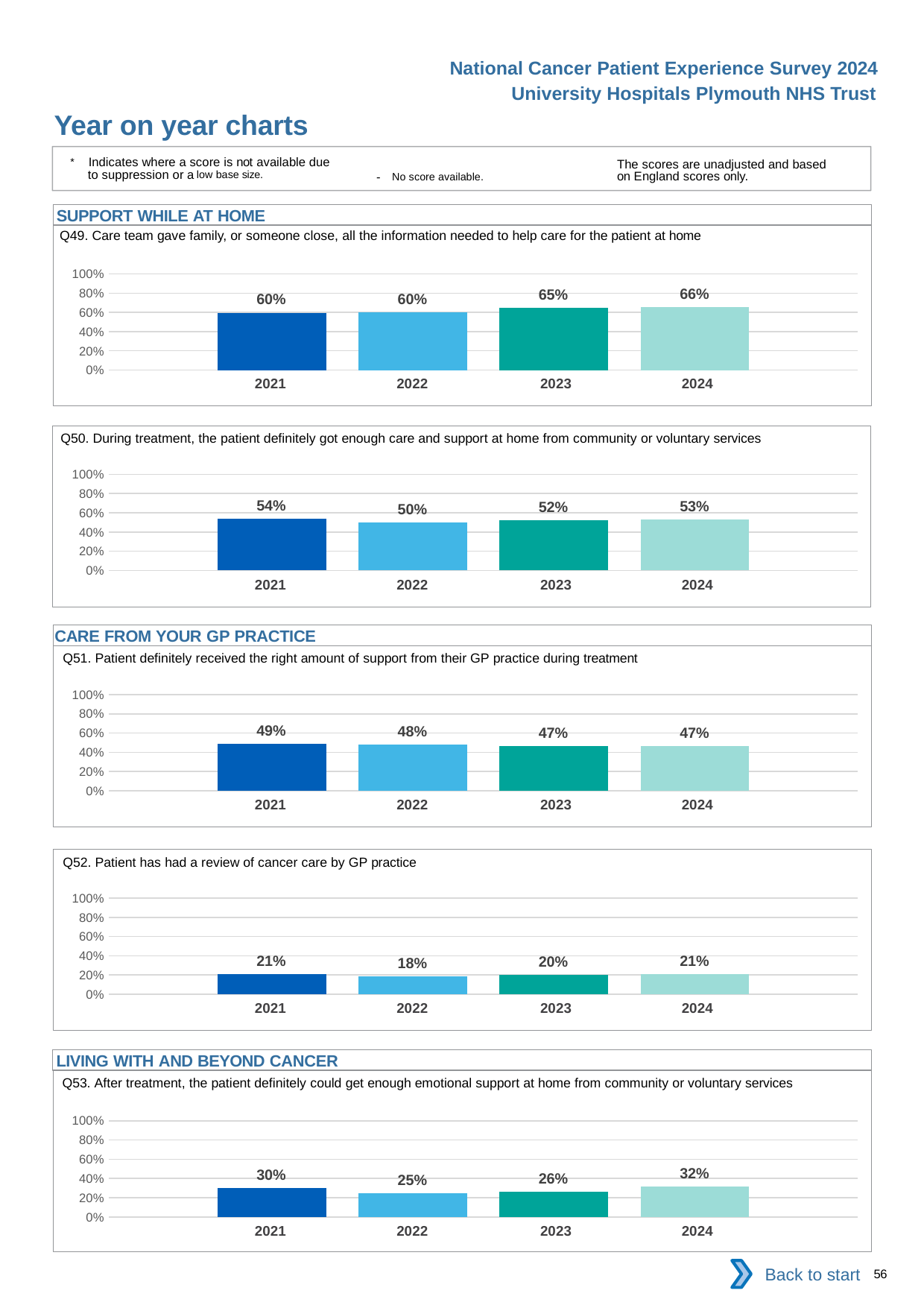
In the Q50 chart, which year has the highest value? 2021 In the Q52 chart, is the value for 2021 greater or less than 40%? less In the Q53 chart, which is larger, the value for 2021 or the value for 2024? 2024 In the Q51 chart, do the values rise or fall from 2021 to 2024? fall In the Q49 chart, which year has the lowest value? 2021 and 2022 (both 60%) In the Q52 chart, which year has the lowest value? 2022 In the Q50 chart, what is the value for 2022? 50% In the Q51 chart, what is the value for 2021? 49% How many years are plotted in the Q53 chart? 4 In the Q49 chart, what is the value for 2024? 66% In the Q53 chart, what is the difference between the 2024 and 2022 values? 7 percentage points In the Q50 chart, what is the difference between the 2021 and 2022 values? 4 percentage points